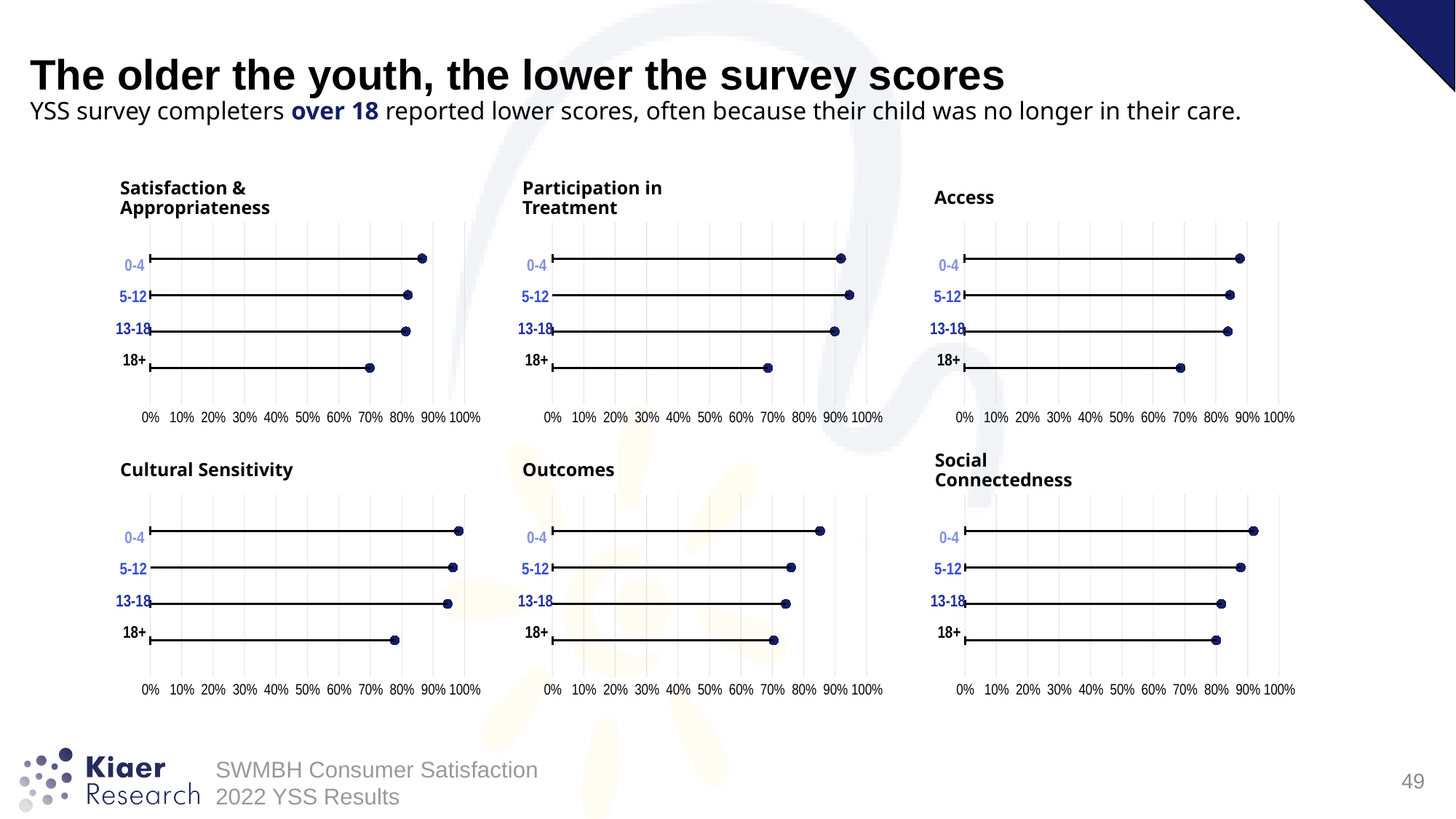
In the Satisfaction & Appropriateness chart, which age group has the highest value? 0-4 In the Cultural Sensitivity chart, is the value for 18+ greater or less than 70%? greater In the Satisfaction & Appropriateness chart, which age group has the lowest value? 18+ In the Access chart, is the value for 18+ greater or less than 80%? less In the Outcomes chart, which age group has the highest value? 0-4 In the Access chart, which of 0-4 or 18+ has the larger value? 0-4 In the Social Connectedness chart, is the value for 0-4 greater or less than 80%? greater How many age groups are shown in the Outcomes chart? 4 In the Cultural Sensitivity chart, do the values rise or fall as the age groups go from 0-4 to 18+? fall How many charts are shown on the slide? 6 In the Participation in Treatment chart, which age group has the lowest value? 18+